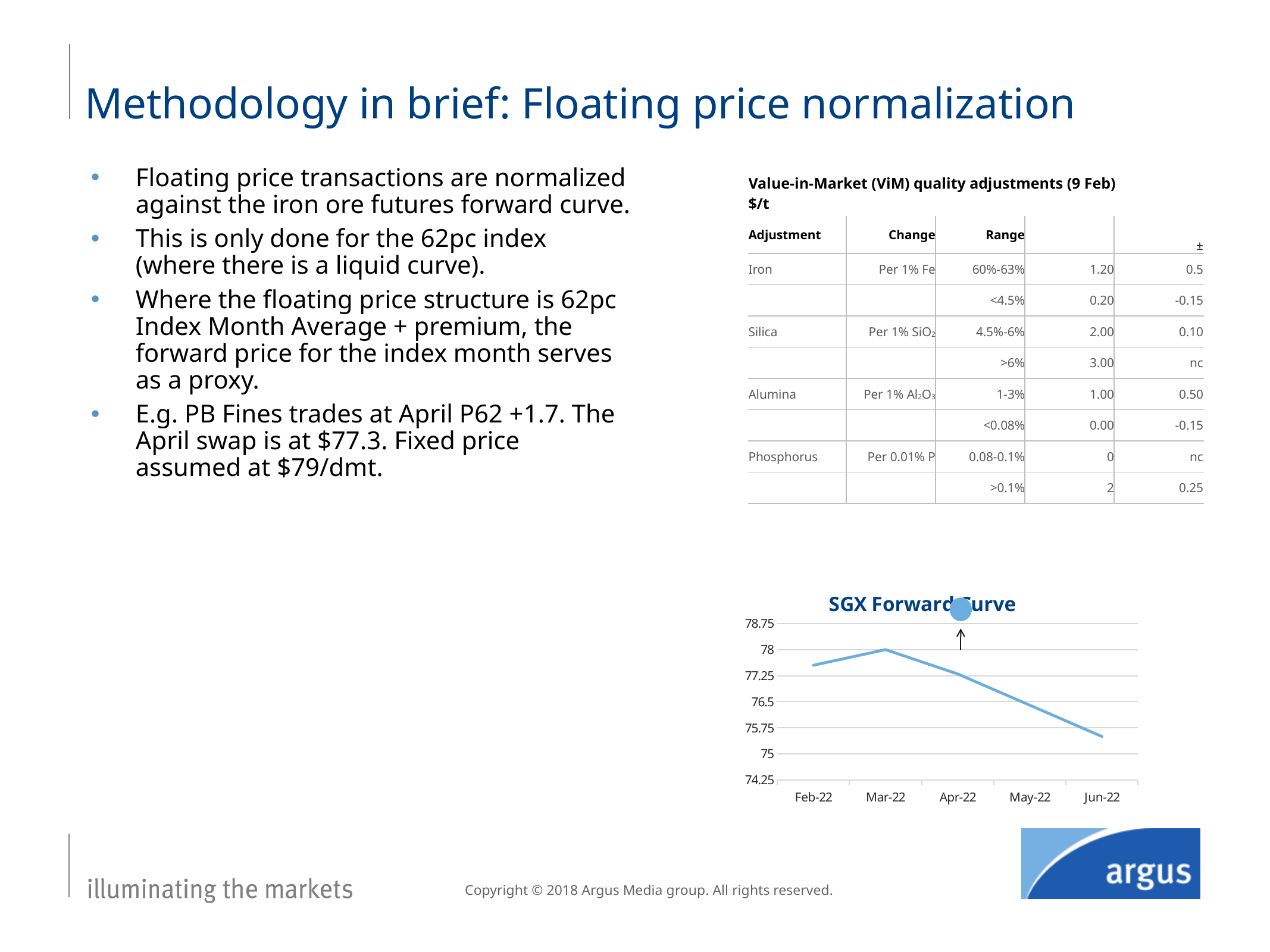
In the SGX Forward Curve chart, do the values rise or fall from Mar-22 to Jun-22? fall In the SGX Forward Curve chart, is the value for Feb-22 greater or less than 77.25? greater In the SGX Forward Curve chart, which is larger, the value for Mar-22 or the value for May-22? Mar-22 What kind of chart is the SGX Forward Curve chart? line chart In the SGX Forward Curve chart, which month has the highest value? Mar-22 In the SGX Forward Curve chart, is the value for Jun-22 greater or less than 75? greater In the SGX Forward Curve chart, is the value for Jun-22 greater or less than 76.5? less How many months are plotted on the x axis of the SGX Forward Curve chart? 5 In the SGX Forward Curve chart, which is larger, the value for Feb-22 or the value for Jun-22? Feb-22 In the SGX Forward Curve chart, which month has the lowest value? Jun-22 What is the title of the line chart on the slide? SGX Forward Curve